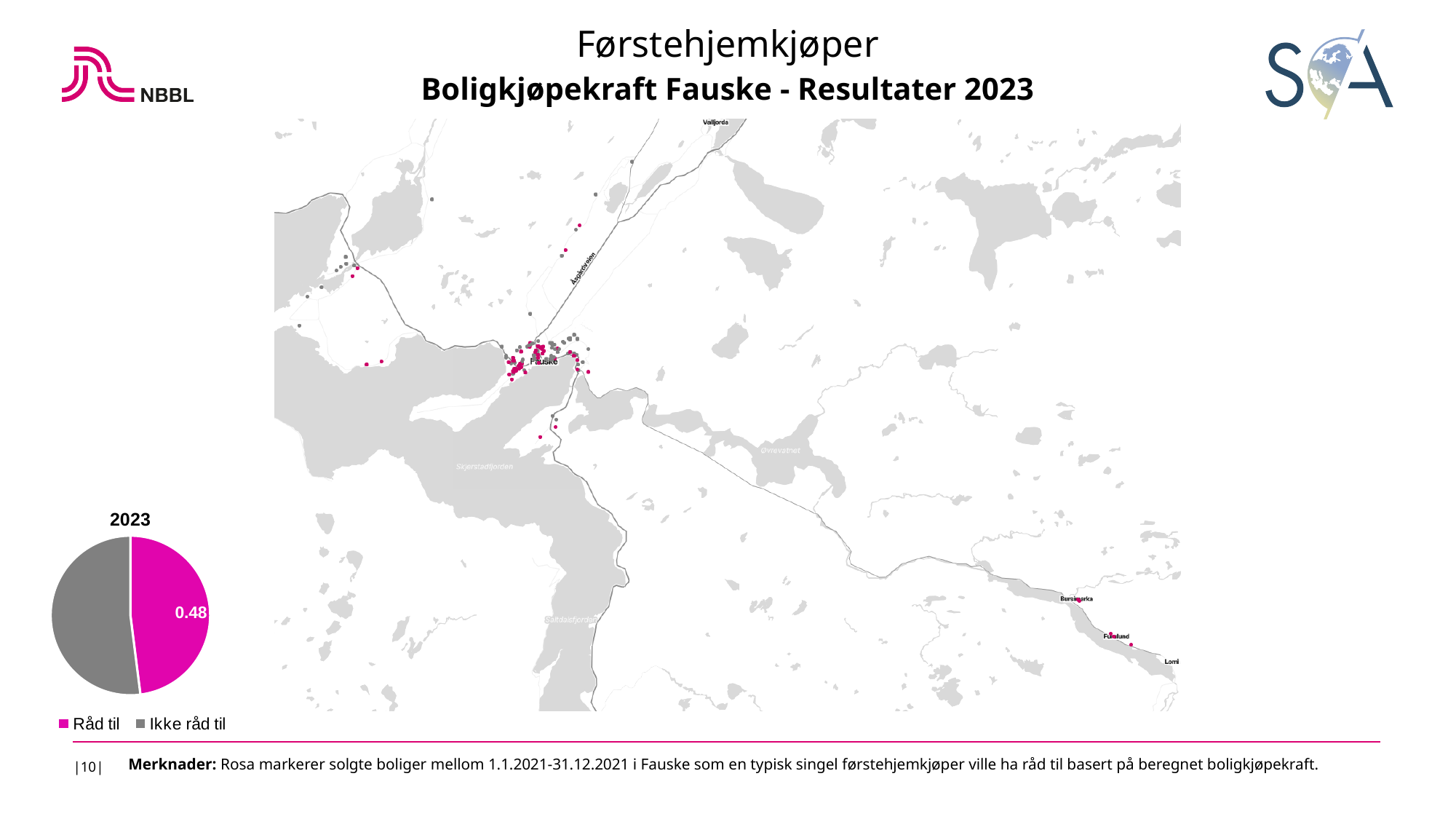
In the pie chart, what value is shown for "Råd til"? 0.48 How many entries does the pie chart's legend list? 2 What is the title shown above the pie chart? 2023 What colour represents "Råd til" in the pie chart? Pink How many slices does the pie chart have? 2 What kind of chart is shown at the bottom left of the slide? Pie chart Which slice of the pie chart is larger, "Råd til" or "Ikke råd til"? Ikke råd til